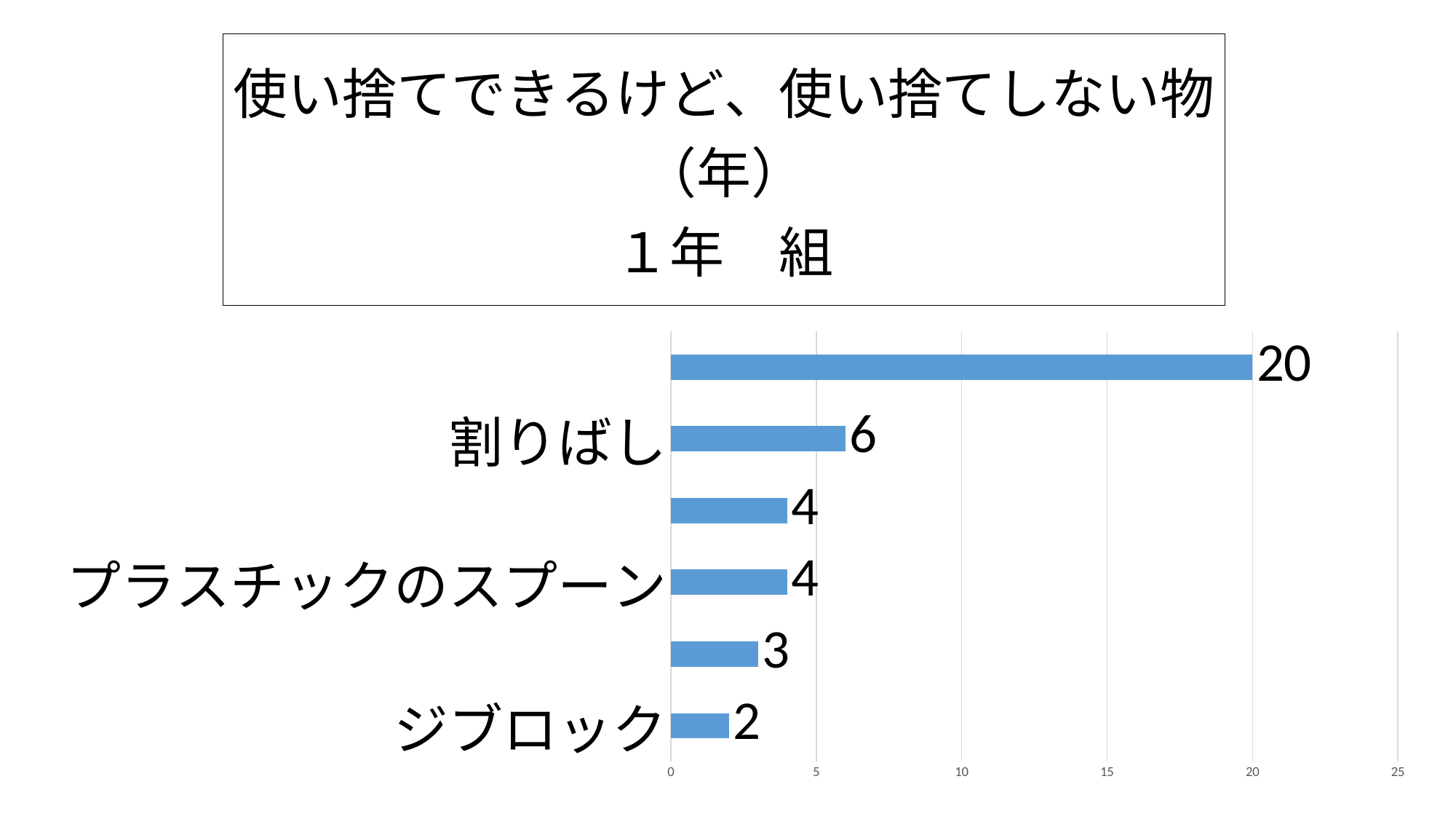
How many bars are plotted on the chart? 6 Which category has the lowest value? ジブロック What is the difference between the values for 割りばし and ジブロック? 4 What is the highest tick value shown on the horizontal axis? 25 What is the difference between the values for 割りばし and プラスチックのスプーン? 2 What is the value for ジブロック? 2 What is the value for 割りばし? 6 What is the value for プラスチックのスプーン? 4 What kind of chart is shown on the slide? bar chart Which is larger, the value for 割りばし or the value for プラスチックのスプーン? 割りばし Is the value for 割りばし greater or less than 5? greater What is the highest value shown on the chart? 20